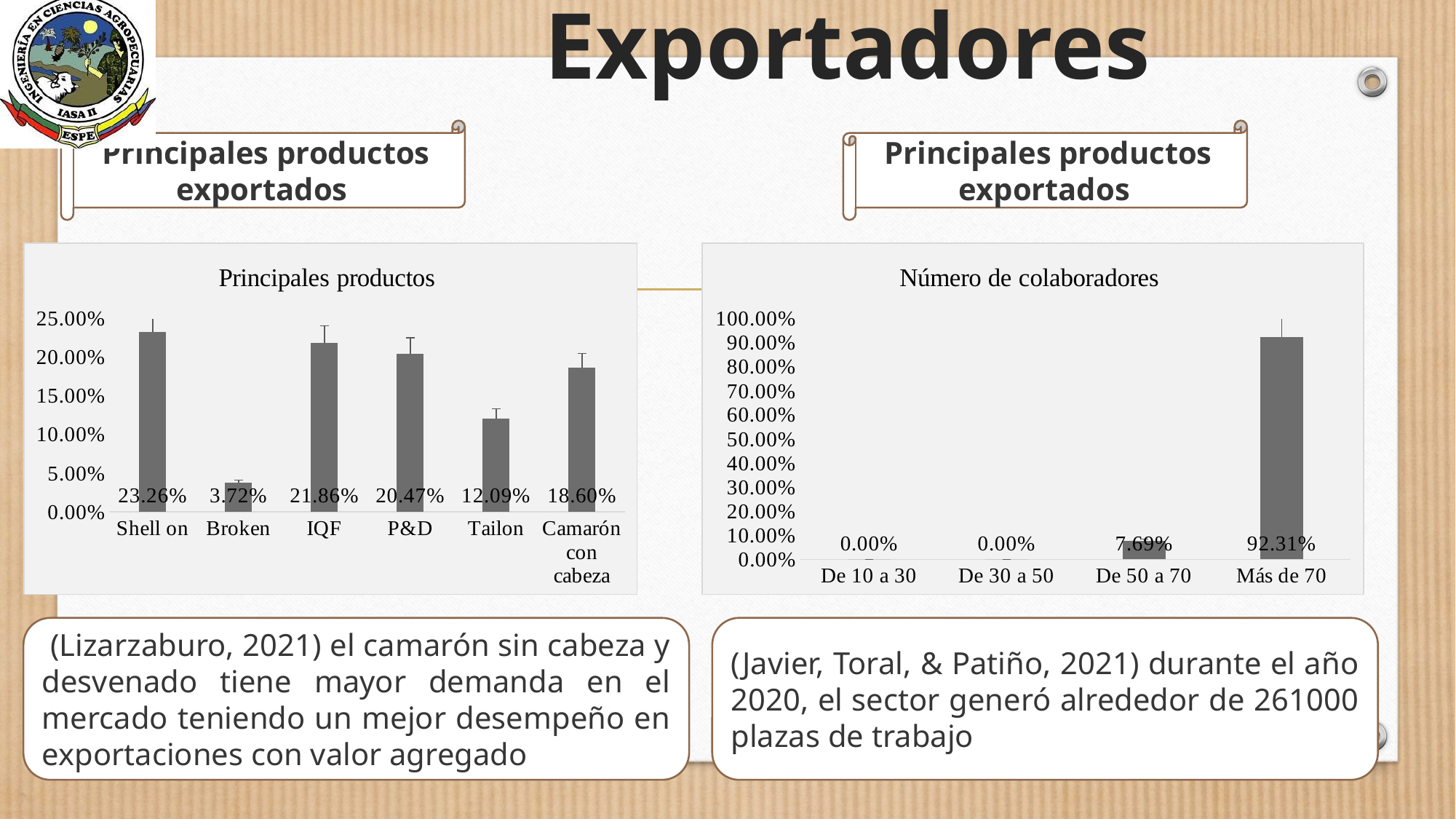
How many categories are shown in the 'Número de colaboradores' chart? 4 In the 'Principales productos' chart, what is the value for Shell on? 23.26% In the 'Número de colaboradores' chart, what is the value for Más de 70? 92.31% In the 'Principales productos' chart, which category has the lowest value? Broken In the 'Principales productos' chart, which category has the highest value? Shell on In the 'Principales productos' chart, what is the difference between the values for IQF and P&D? 1.39% How many categories are shown in the 'Principales productos' chart? 6 In the 'Número de colaboradores' chart, which category has the highest value? Más de 70 In the 'Principales productos' chart, what is the value for Broken? 3.72% In the 'Número de colaboradores' chart, what is the value for De 50 a 70? 7.69% What type of chart is the 'Número de colaboradores' chart? Bar chart In the 'Principales productos' chart, which is larger, the value for Tailon or the value for Camarón con cabeza? Camarón con cabeza